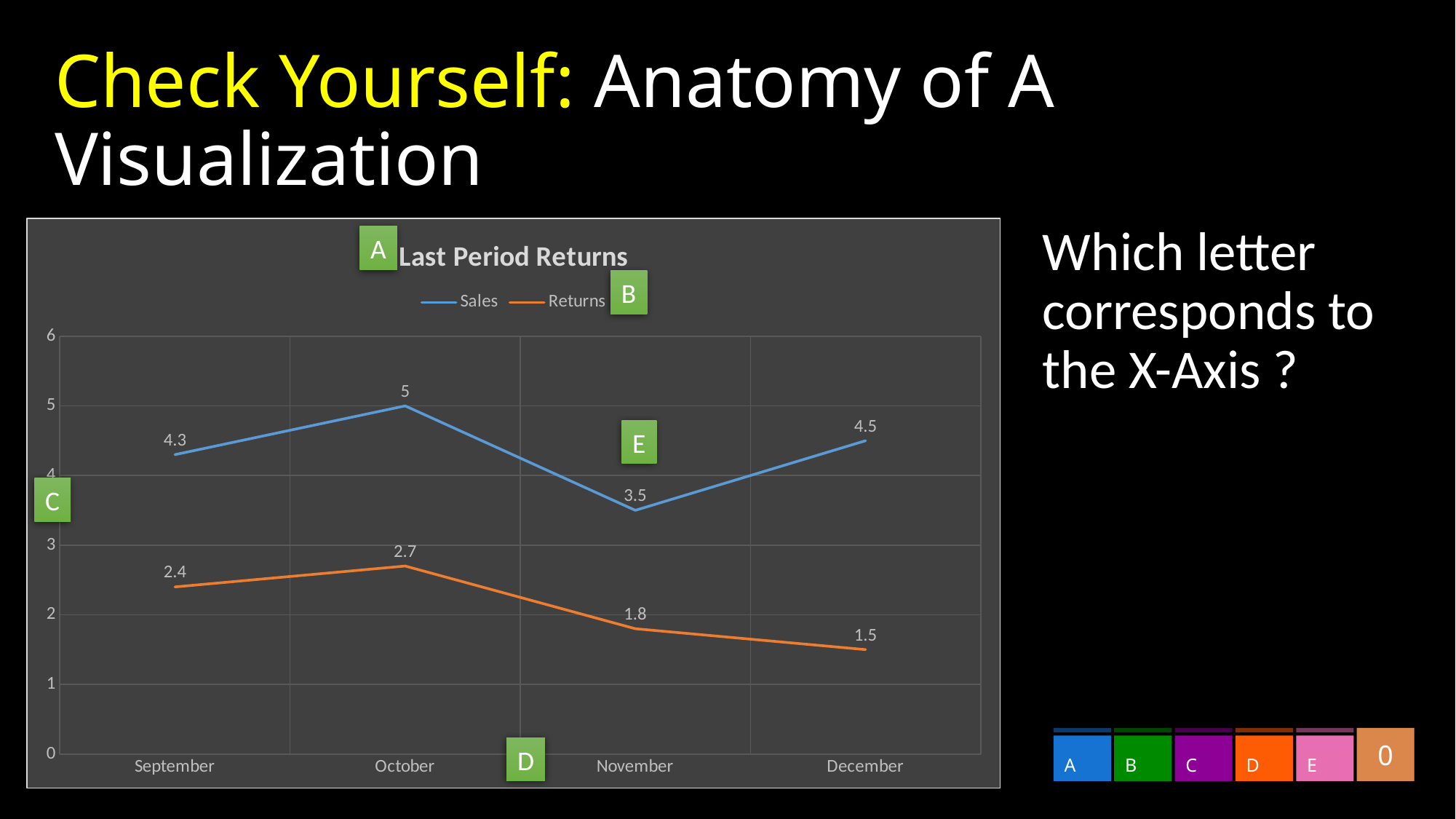
How many months are shown on the x axis? 4 Which is larger, Returns in October or Returns in December? Returns in October In which month is Returns highest? October Does the Returns series rise or fall from October to December? Fall What is the difference between Sales and Returns in September? 1.9 What is the Sales value for December? 4.5 What kind of chart is shown? Line chart What is the title of the chart? Last Period Returns What is the Sales value for October? 5 How many series does the legend list? 2 In which month is Sales lowest? November What is the Returns value for November? 1.8